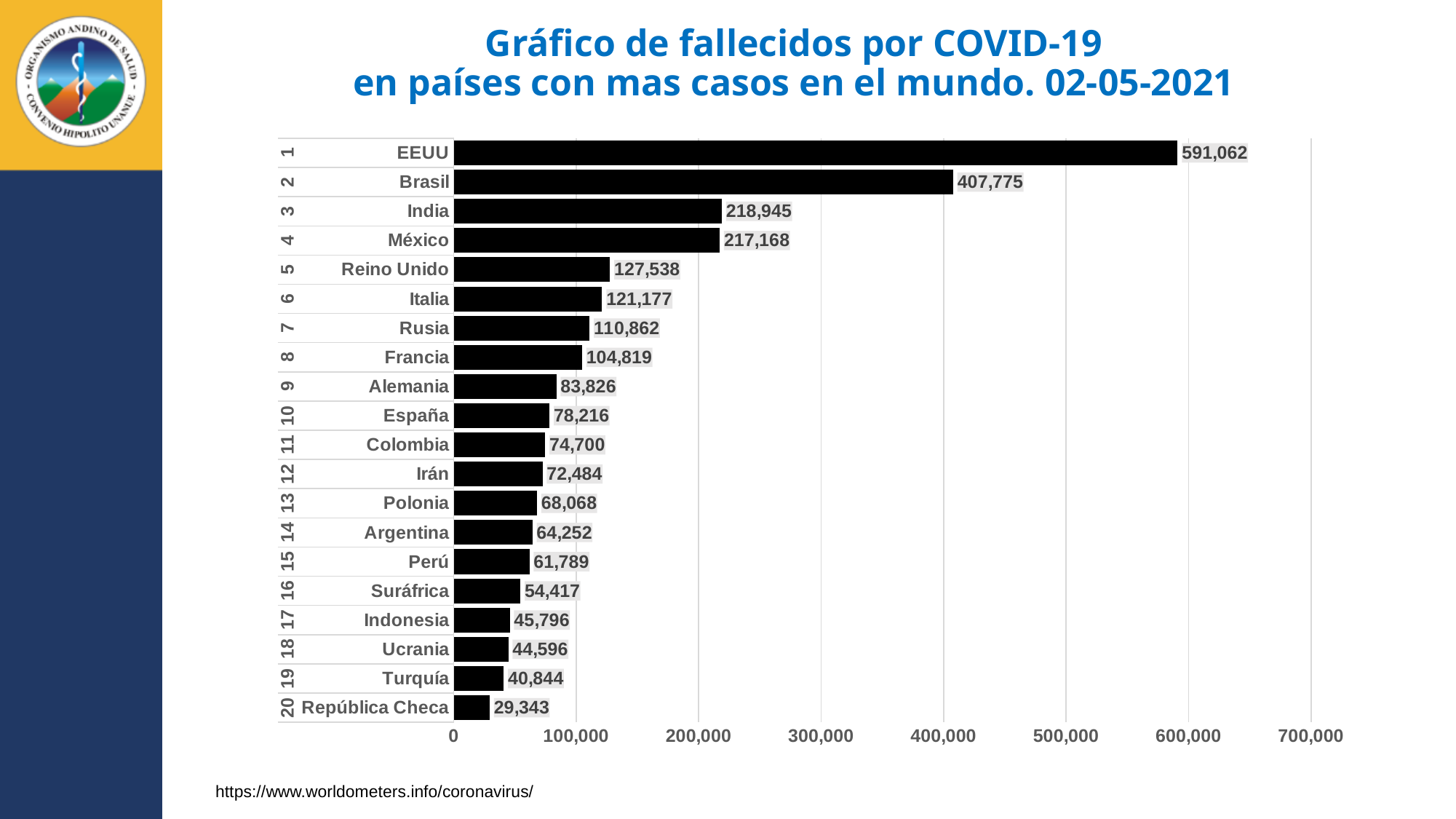
What is the date shown in the chart title? 02-05-2021 Which country has the lowest value? República Checa Which is larger, the value for Italia or the value for Rusia? Italia What is the value for Reino Unido? 127,538 What is the value for Perú? 61,789 Which country has the highest value? EEUU What is the value for Brasil? 407,775 What is the difference between the values for Alemania and España? 5,610 Is the value for México greater or less than 200,000? greater What kind of chart is shown on the slide? bar chart What is the difference between the values for EEUU and Brasil? 183,287 How many countries are shown in the chart? 20